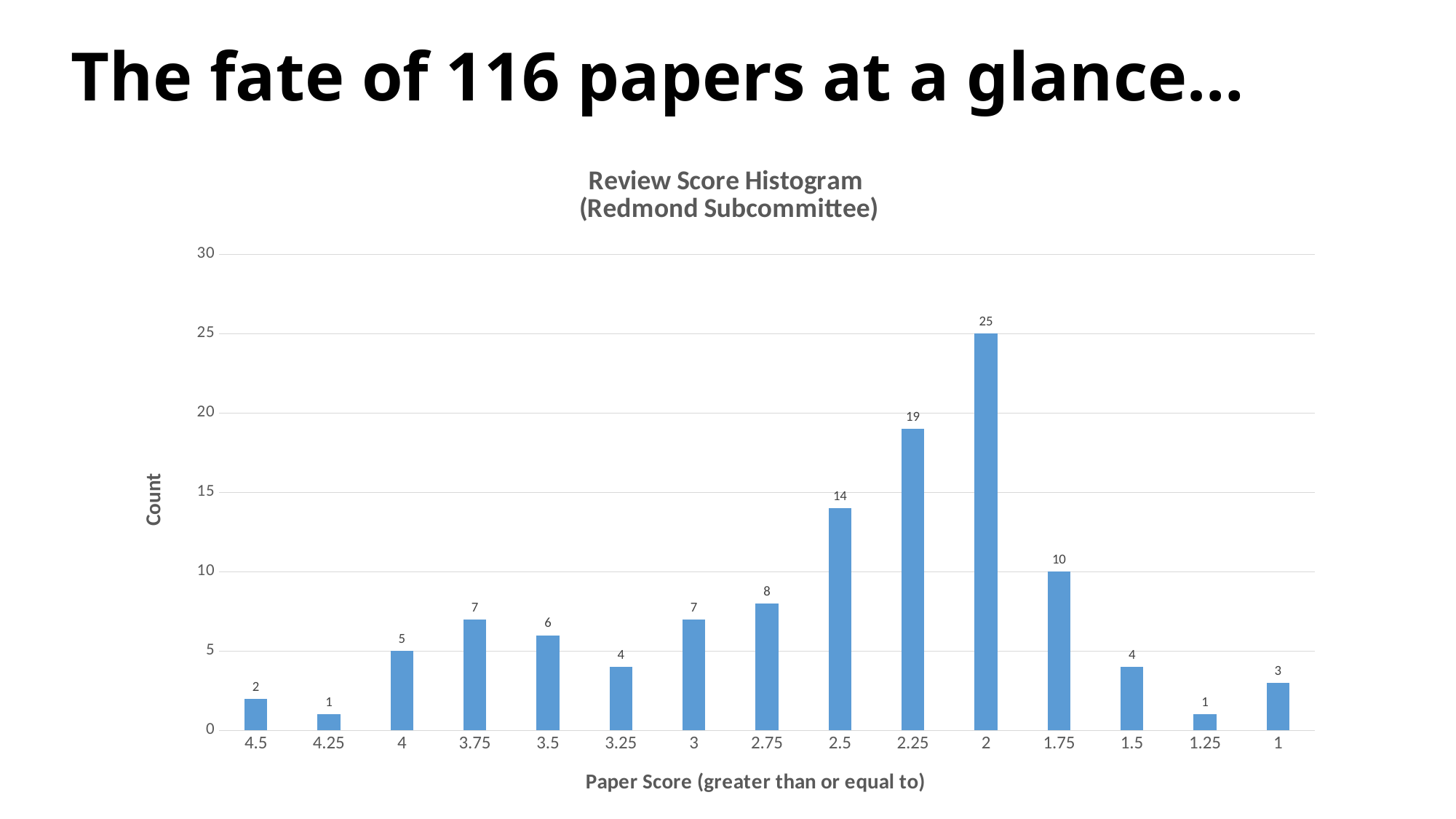
What is the title of the chart? Review Score Histogram (Redmond Subcommittee) How many paper score categories are shown on the x axis? 15 Which paper scores have the lowest count? 4.25 and 1.25 Which has a larger count, paper score 1.75 or paper score 2.75? 1.75 What is the label of the y axis? Count What is the count for a paper score of 2.5? 14 Which paper score has the highest count? 2 What kind of chart is shown on the slide? bar chart What is the count for a paper score of 3.75? 7 What is the difference between the counts for paper scores 2 and 2.25? 6 What is the count for a paper score of 2? 25 Is the count for paper score 2.25 greater or less than 15? greater